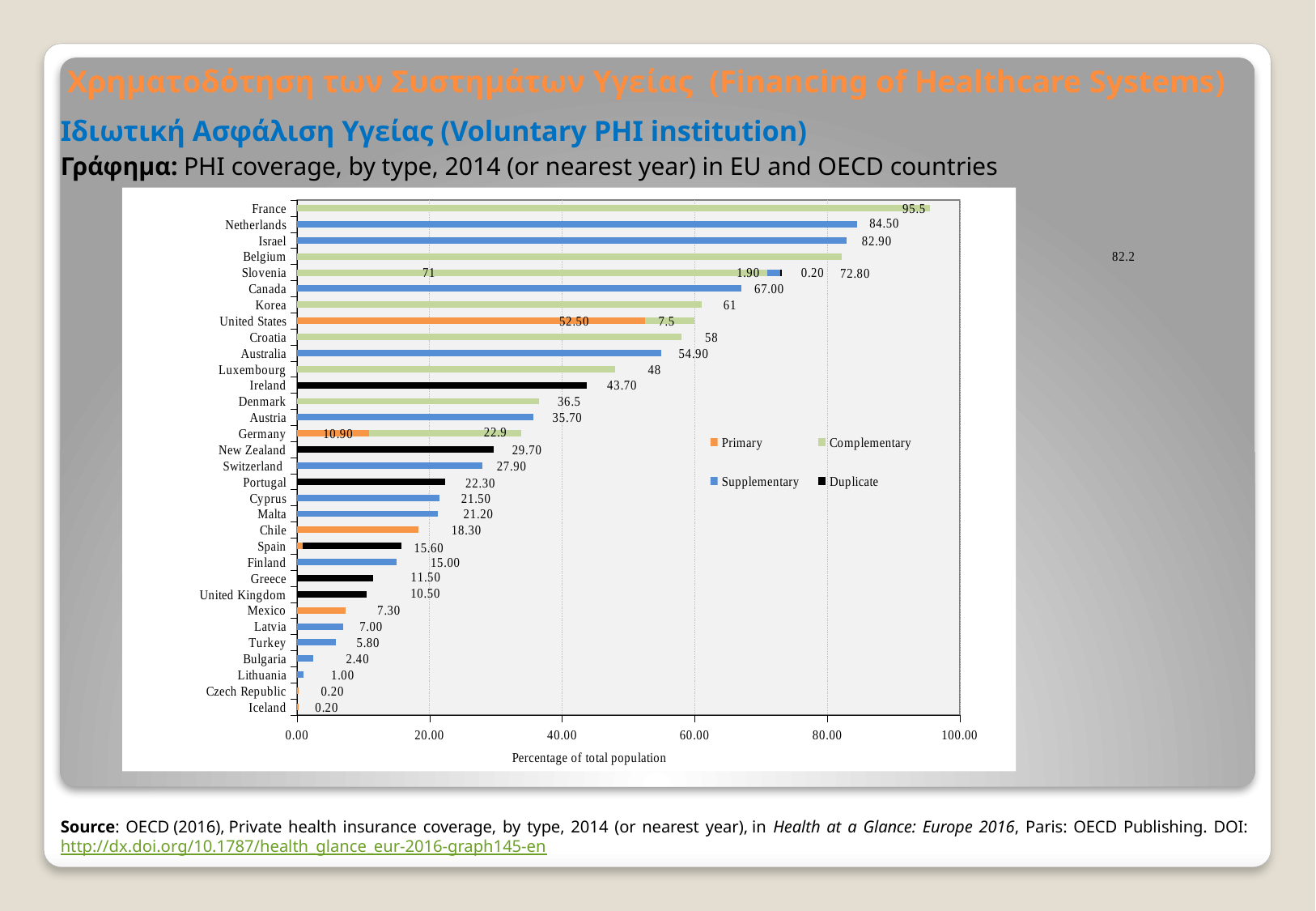
What is the difference between the values for the Netherlands and Israel? 1.60 What is the title of the horizontal axis? Percentage of total population What is the value shown for Canada? 67.00 What is the value shown for Ireland? 43.70 What is the value shown for the Netherlands? 84.50 Which country has the highest PHI coverage in the chart? France How many series does the legend list? 4 Is the value for Belgium greater or less than 80? greater Which has a larger value, Croatia or Australia? Croatia What is the PHI coverage value shown for France? 95.5 What is the Primary coverage value shown for Chile? 18.30 What kind of chart is shown on the slide? Bar chart